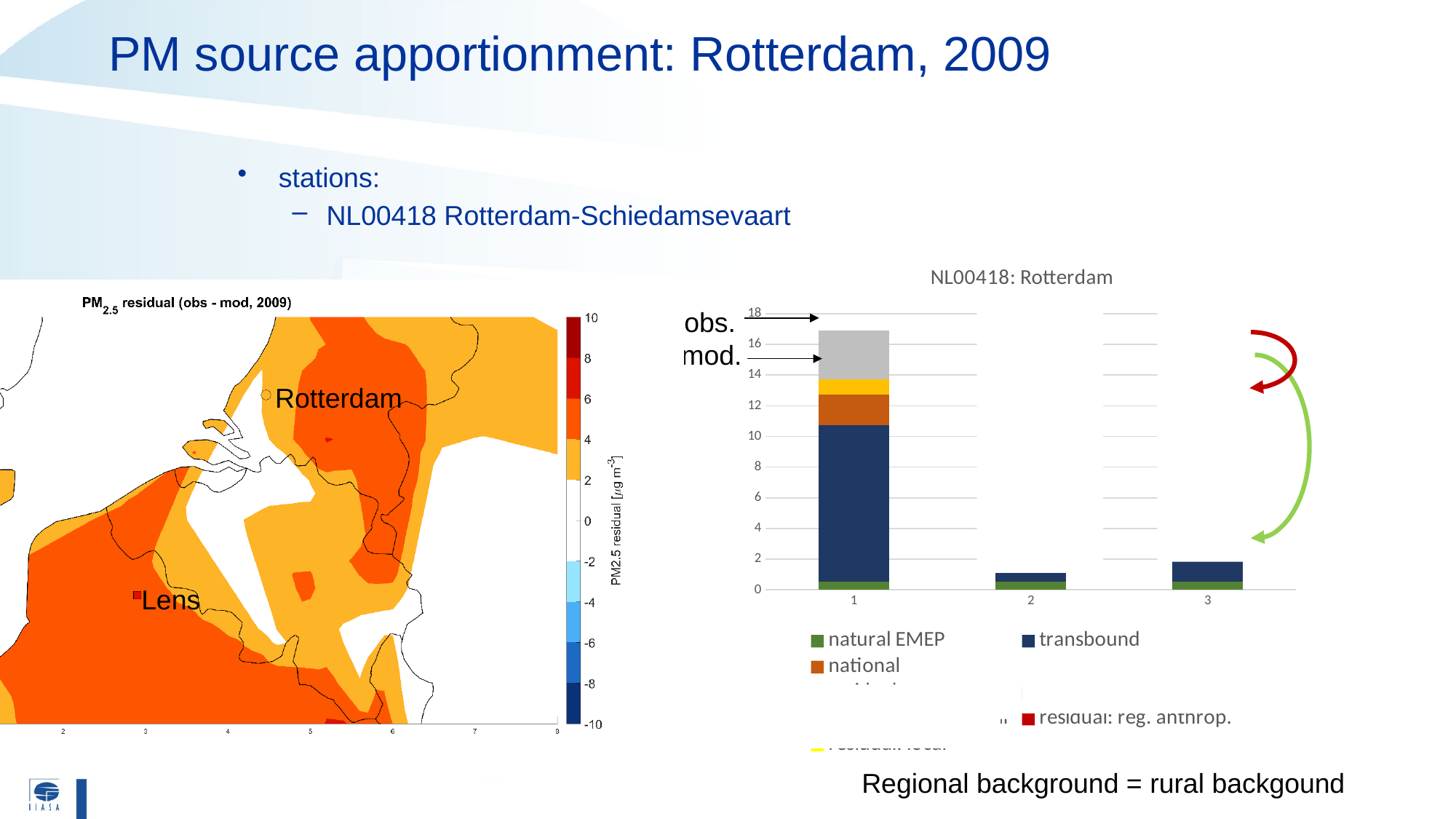
In the 'NL00418: Rotterdam' chart, which series makes up the largest part of bar 1? transbound What is the title of the bar chart on the right of the slide? NL00418: Rotterdam In the 'NL00418: Rotterdam' chart, which category has the shortest stacked bar? 2 How many bars (categories) are shown on the x axis of the 'NL00418: Rotterdam' chart? 3 In the 'NL00418: Rotterdam' chart, which category has the tallest stacked bar? 1 In the 'NL00418: Rotterdam' chart, is the total height of bar 3 greater or less than 4? less In the 'NL00418: Rotterdam' chart, what colour represents the 'transbound' series? dark blue In the 'NL00418: Rotterdam' chart, is the transbound segment of bar 1 greater or less than 8? greater In the 'NL00418: Rotterdam' chart, which bar is taller, bar 1 or bar 3? bar 1 In the 'NL00418: Rotterdam' chart, is the total height of bar 2 greater or less than 2? less What kind of chart is the 'NL00418: Rotterdam' chart? stacked bar chart